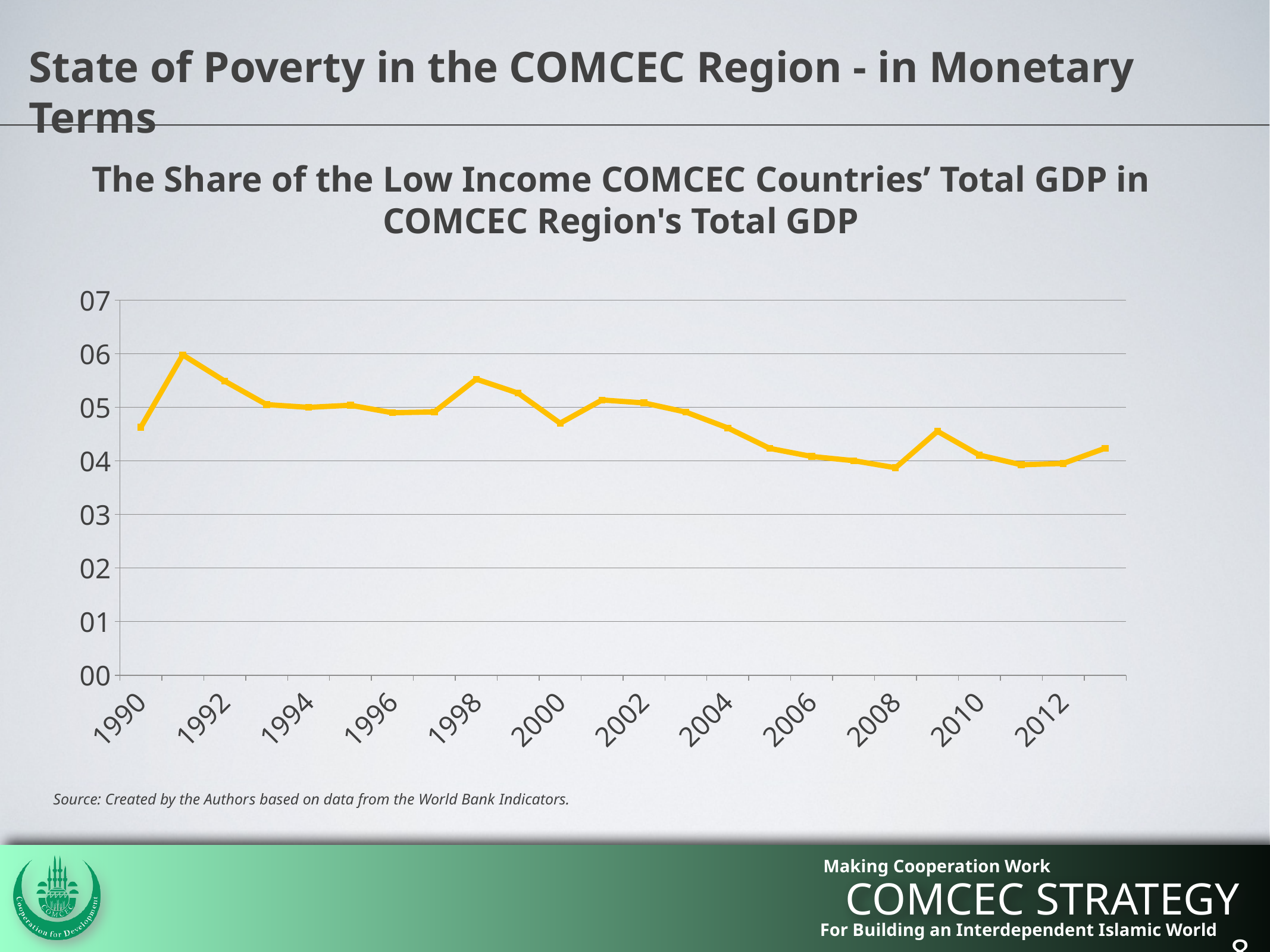
Is the value for 2008 greater or less than 04? less Is the value for 2009 greater or less than 04? greater What is the title of the chart? The Share of the Low Income COMCEC Countries' Total GDP in COMCEC Region's Total GDP Is the value for 2000 greater or less than 05? less In which year does the share of the low income COMCEC countries' total GDP reach its highest value? 1991 Does the share generally rise or fall between 1991 and 2008? fall What kind of chart is shown on the slide? line chart Which year has the larger value, 1991 or 1998? 1991 Which year has the larger value, 1990 or 2008? 1990 What colour is the line plotted on the chart? yellow